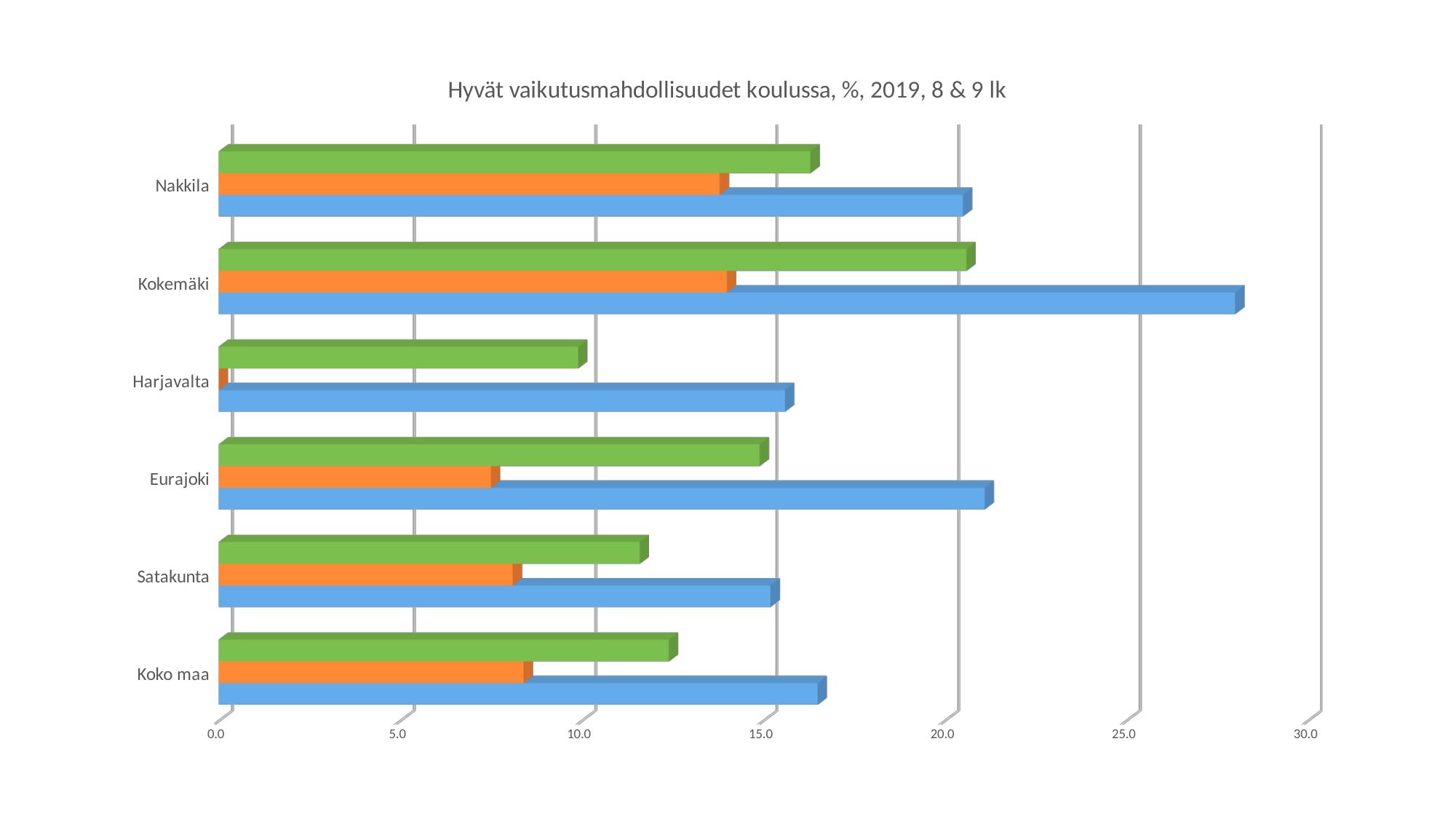
Is the value of the orange bar for Eurajoki greater or less than 10.0? less Is the value of the green bar for Nakkila greater or less than 15.0? greater Is the value of the blue bar for Kokemäki greater or less than 25.0? greater Which category has the shortest orange bar? Harjavalta What is the title of the chart? Hyvät vaikutusmahdollisuudet koulussa, %, 2019, 8 & 9 lk How many bars are shown for each category in the chart? 3 Which has the longer green bar, Kokemäki or Satakunta? Kokemäki What kind of chart is shown on the slide? bar chart How many categories are shown on the vertical axis of the chart? 6 Which category has the longest blue bar? Kokemäki